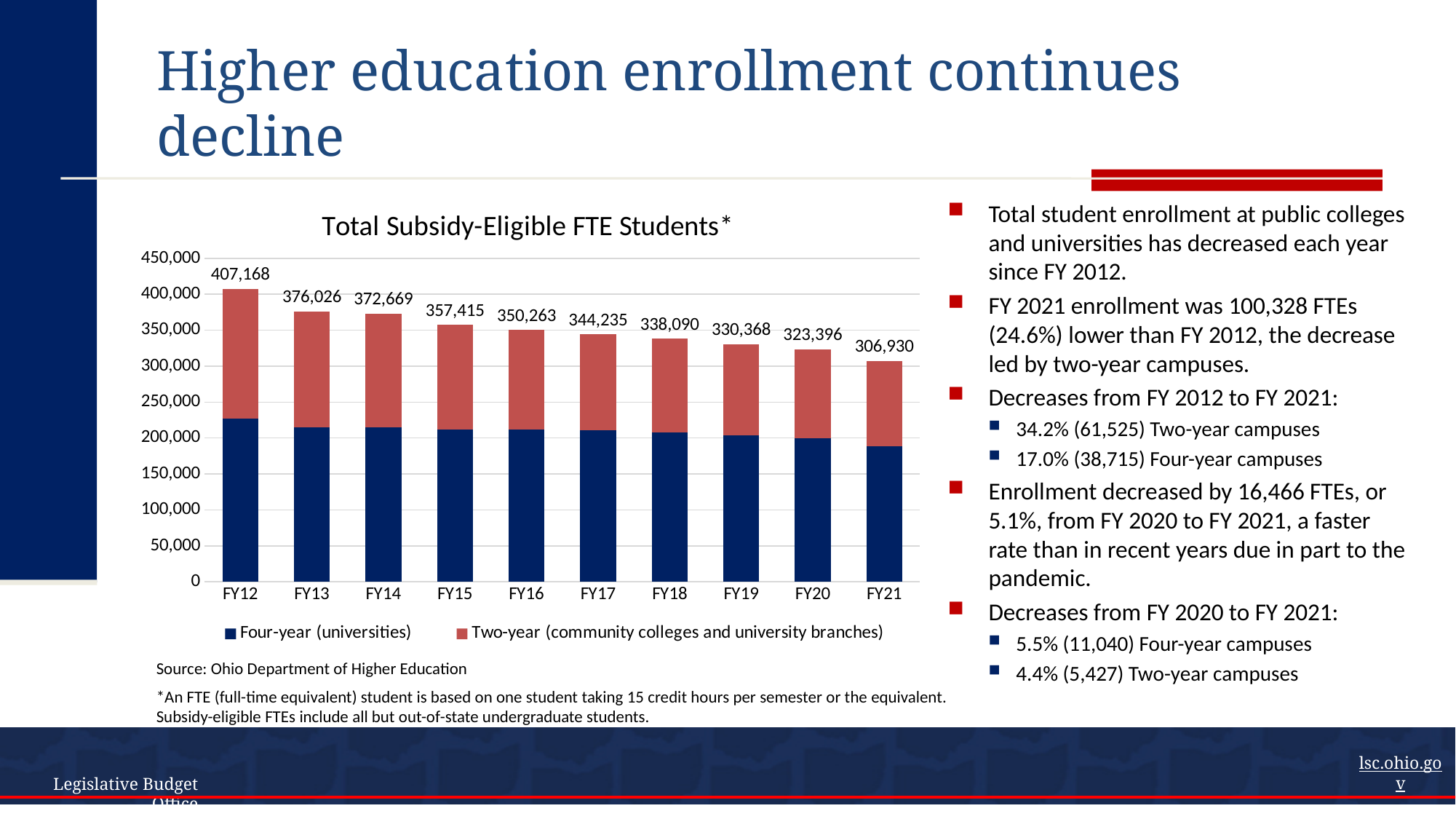
What is the total number of subsidy-eligible FTE students shown for FY12? 407,168 What is the difference between the FY12 total and the FY21 total? 100,238 What is the total value labeled on the FY17 bar? 344,235 What is the difference between the FY20 total and the FY21 total? 16,466 Which is larger, the total for FY13 or the total for FY14? FY13 Do the total values rise or fall from FY12 to FY21? fall Which fiscal year has the highest total of subsidy-eligible FTE students? FY12 Which fiscal year has the lowest total of subsidy-eligible FTE students? FY21 What is the total value labeled on the FY21 bar? 306,930 How many series does the legend list? 2 Is the Four-year (universities) value for FY12 greater or less than 200,000? greater How many fiscal years are shown on the x axis? 10